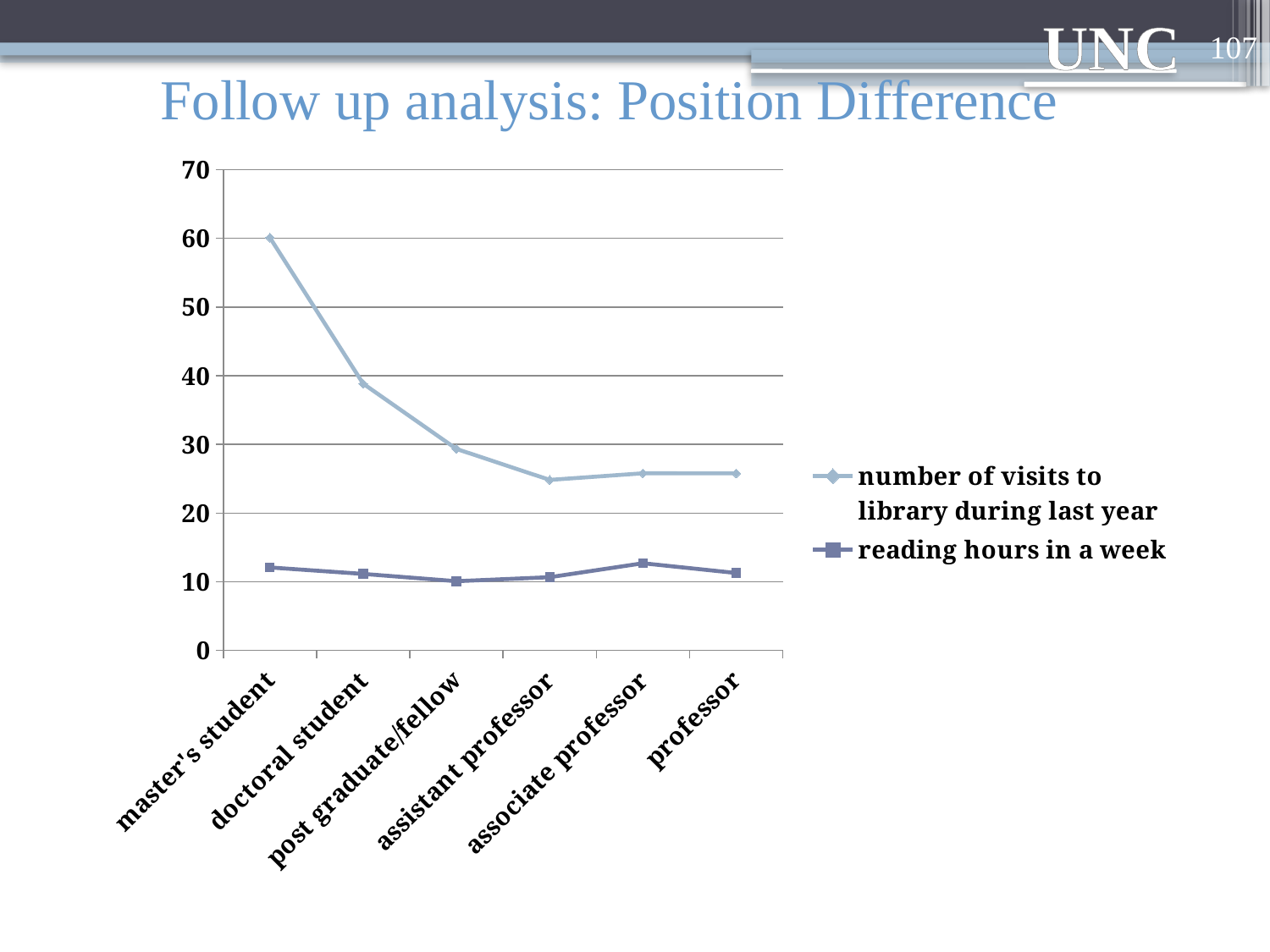
Which position has the highest number of visits to library during last year? master's student How many series does the legend list? 2 Which has more visits to library during last year, master's student or professor? master's student Is the number of visits to library during last year for assistant professor greater or less than 30? less How many positions are shown along the x axis? 6 What is the title of the slide containing the chart? Follow up analysis: Position Difference Which has more visits to library during last year, doctoral student or post graduate/fellow? doctoral student Is the value of reading hours in a week for master's student greater or less than 20? less What kind of chart is shown on the slide? line chart Do the number of visits to library during last year rise or fall from master's student to assistant professor? fall